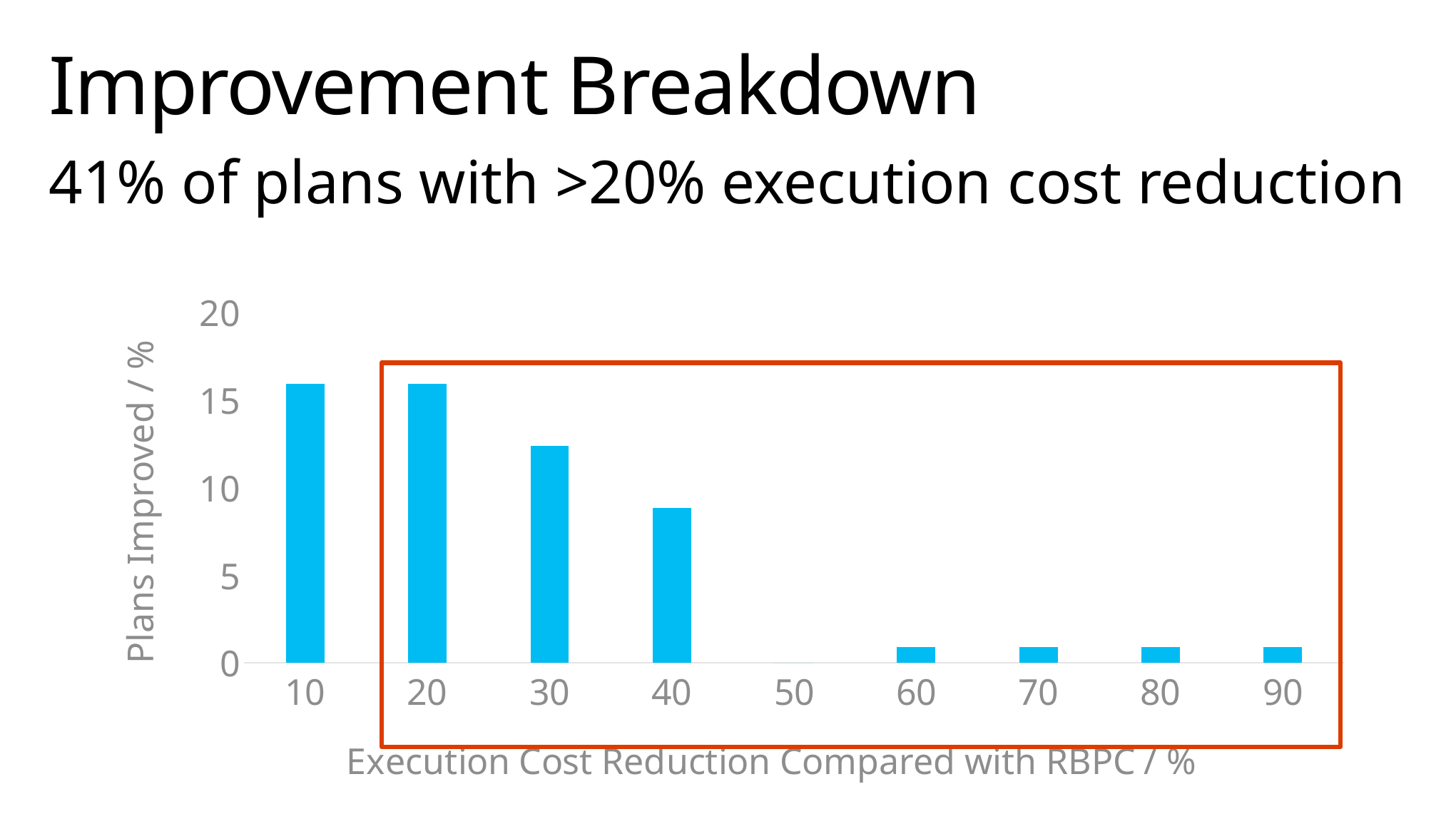
What is the label of the y axis? Plans Improved / % Is the value for the 30 category greater or less than 15? less Is the value for the 60 category greater or less than 5? less What is the label of the x axis? Execution Cost Reduction Compared with RBPC / % Is the value for the 10 category greater or less than 15? greater What kind of chart is shown on the slide? bar chart Which has the larger value, the 30 category or the 40 category? 30 Which has the larger value, the 40 category or the 70 category? 40 Which x-axis category has the lowest value (no visible bar)? 50 How many categories are shown on the x axis of the chart? 9 Do the values generally rise or fall as you move from left to right along the x axis? fall